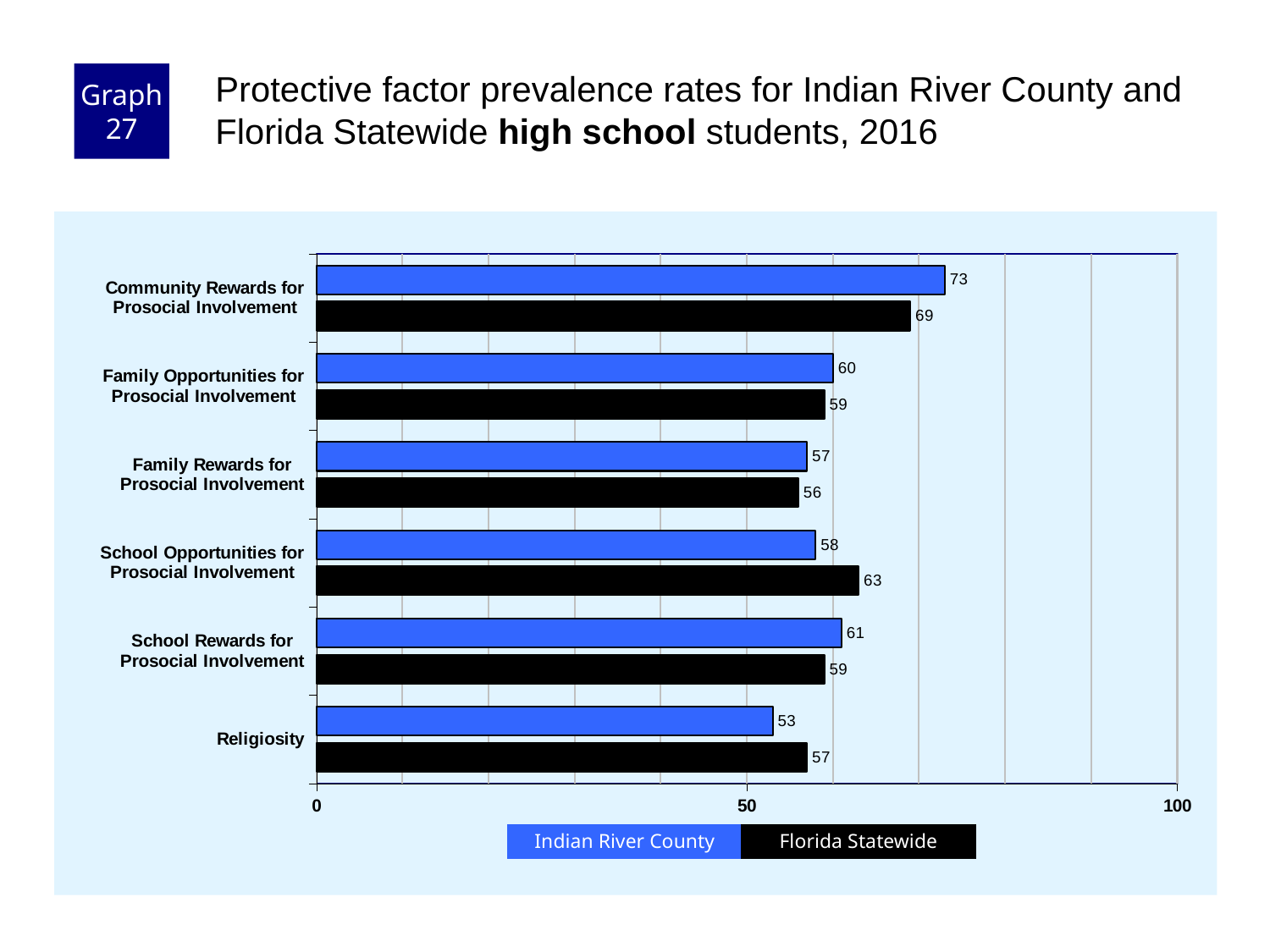
Is the Florida Statewide value for Community Rewards for Prosocial Involvement greater or less than 50? greater What is the Florida Statewide value for School Opportunities for Prosocial Involvement? 63 How many protective factors are shown on the chart? 6 What is the difference between the Indian River County and Florida Statewide values for Community Rewards for Prosocial Involvement? 4 What is the Indian River County value for Community Rewards for Prosocial Involvement? 73 For Religiosity, which is larger: the Indian River County value or the Florida Statewide value? Florida Statewide Which protective factor has the highest Indian River County value? Community Rewards for Prosocial Involvement Which protective factor has the lowest Florida Statewide value? Family Rewards for Prosocial Involvement What is the Indian River County value for Religiosity? 53 What kind of chart is shown on the slide? bar chart How many series does the legend list? 2 What is the difference between the Florida Statewide and Indian River County values for School Opportunities for Prosocial Involvement? 5